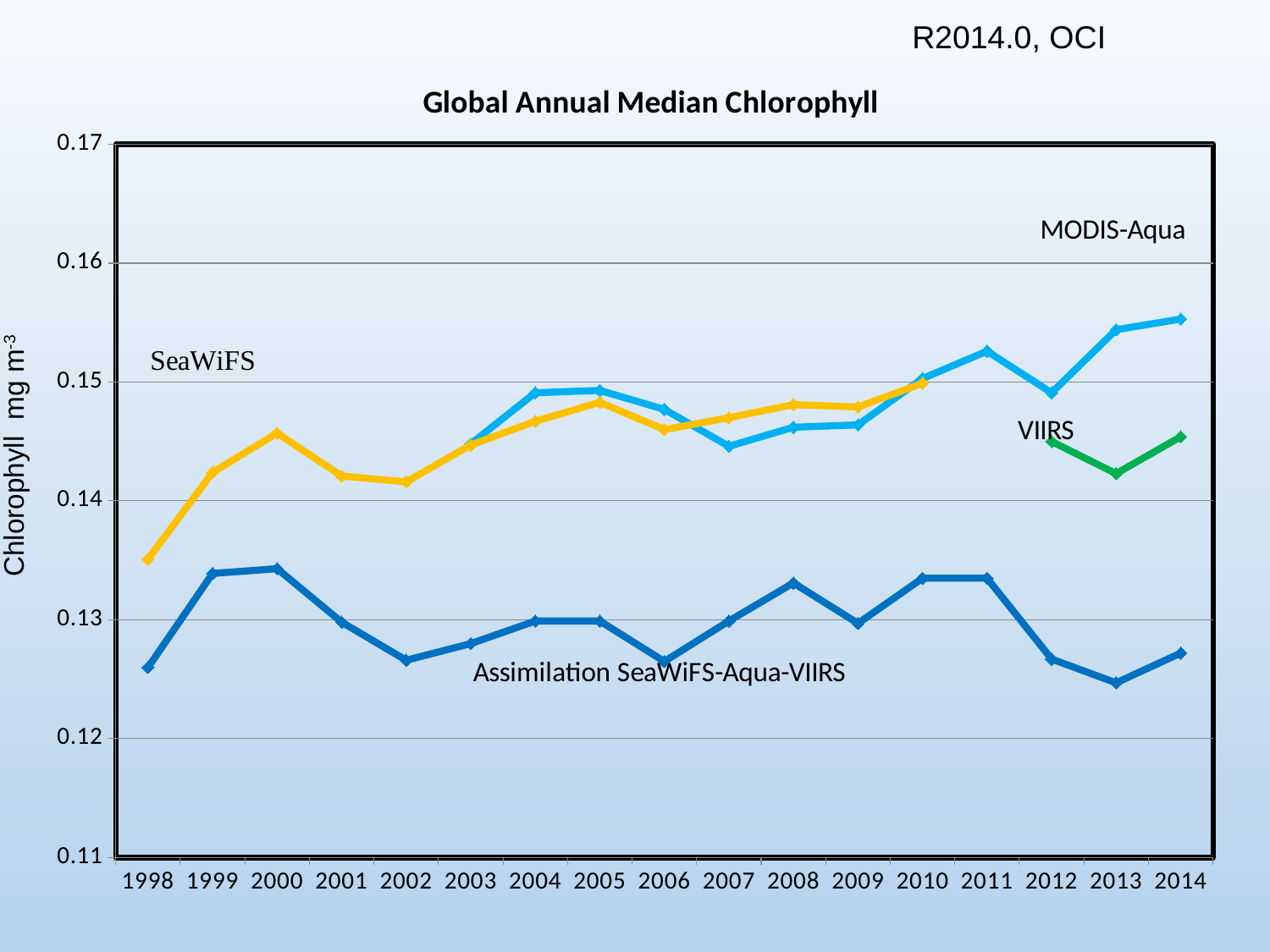
In 2014, which is larger: the MODIS-Aqua value or the Assimilation SeaWiFS-Aqua-VIIRS value? MODIS-Aqua Is the VIIRS value for 2013 greater or less than 0.14? greater What is the title of the chart? Global Annual Median Chlorophyll Is the SeaWiFS value for 1998 greater or less than 0.14? less How many data series are labelled on the chart? 4 Does the SeaWiFS series rise or fall from 1998 to 2000? rise Which series has the lowest values across the whole chart? Assimilation SeaWiFS-Aqua-VIIRS In which year is the SeaWiFS series at its lowest? 1998 What kind of chart is shown on the slide? line chart Is the Assimilation SeaWiFS-Aqua-VIIRS value for 2013 greater or less than 0.13? less How many years are shown along the x axis of the chart? 17